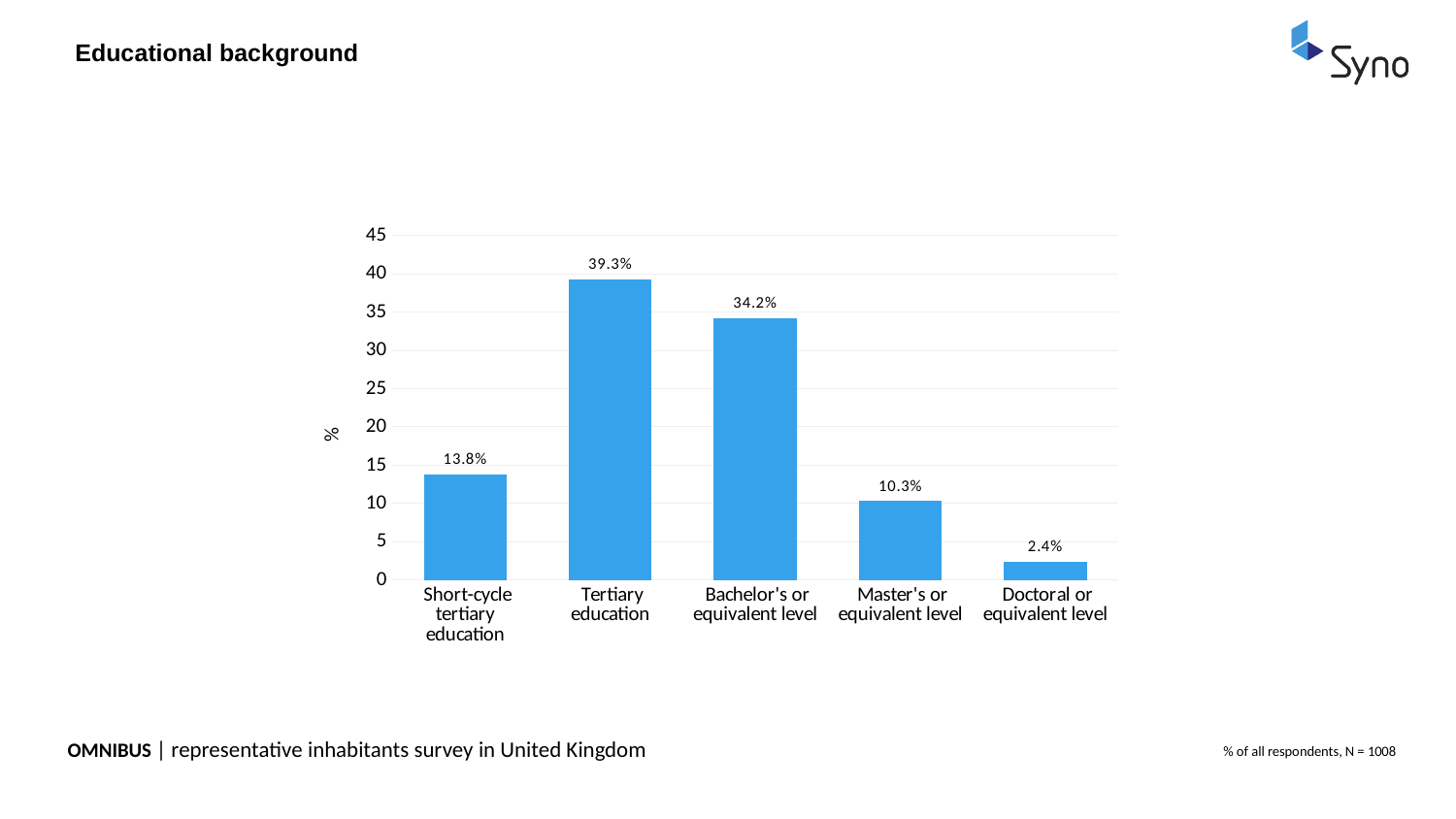
What is the value for Bachelor's or equivalent level? 34.2% How many categories are shown on the x axis? 5 Which is larger, the value for Short-cycle tertiary education or Master's or equivalent level? Short-cycle tertiary education What kind of chart is shown on the slide? bar chart What is the value for Short-cycle tertiary education? 13.8% Is the value for Master's or equivalent level greater or less than 15? less What is the value for Doctoral or equivalent level? 2.4% What is the value for Tertiary education? 39.3% What is the difference between the values for Tertiary education and Bachelor's or equivalent level? 5.1% Which category has the lowest value? Doctoral or equivalent level Which category has the highest value? Tertiary education What is the title of the slide? Educational background